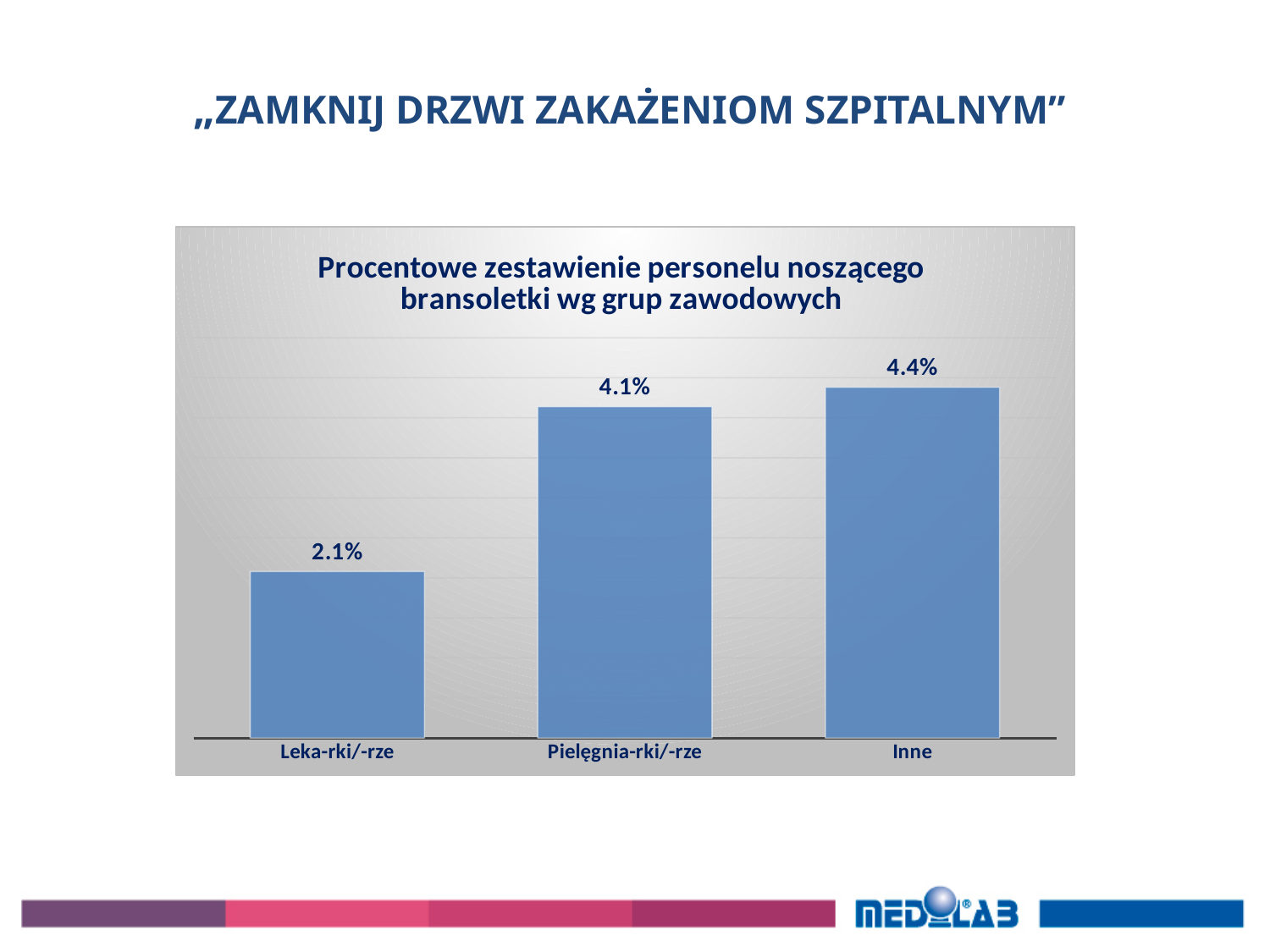
What is the title of the chart? Procentowe zestawienie personelu noszącego bransoletki wg grup zawodowych What kind of chart is shown on the slide? Bar chart Which category has the highest value? Inne What is the value for Inne? 4.4% What is the difference between the values for Inne and Leka-rki/-rze? 2.3% How many categories are shown in the chart? 3 Which is larger, the value for Pielęgnia-rki/-rze or the value for Leka-rki/-rze? Pielęgnia-rki/-rze What is the difference between the values for Pielęgnia-rki/-rze and Leka-rki/-rze? 2.0% What is the value for Leka-rki/-rze? 2.1% What is the value for Pielęgnia-rki/-rze? 4.1% Do the values rise or fall from left to right across the categories? Rise Which category has the lowest value? Leka-rki/-rze